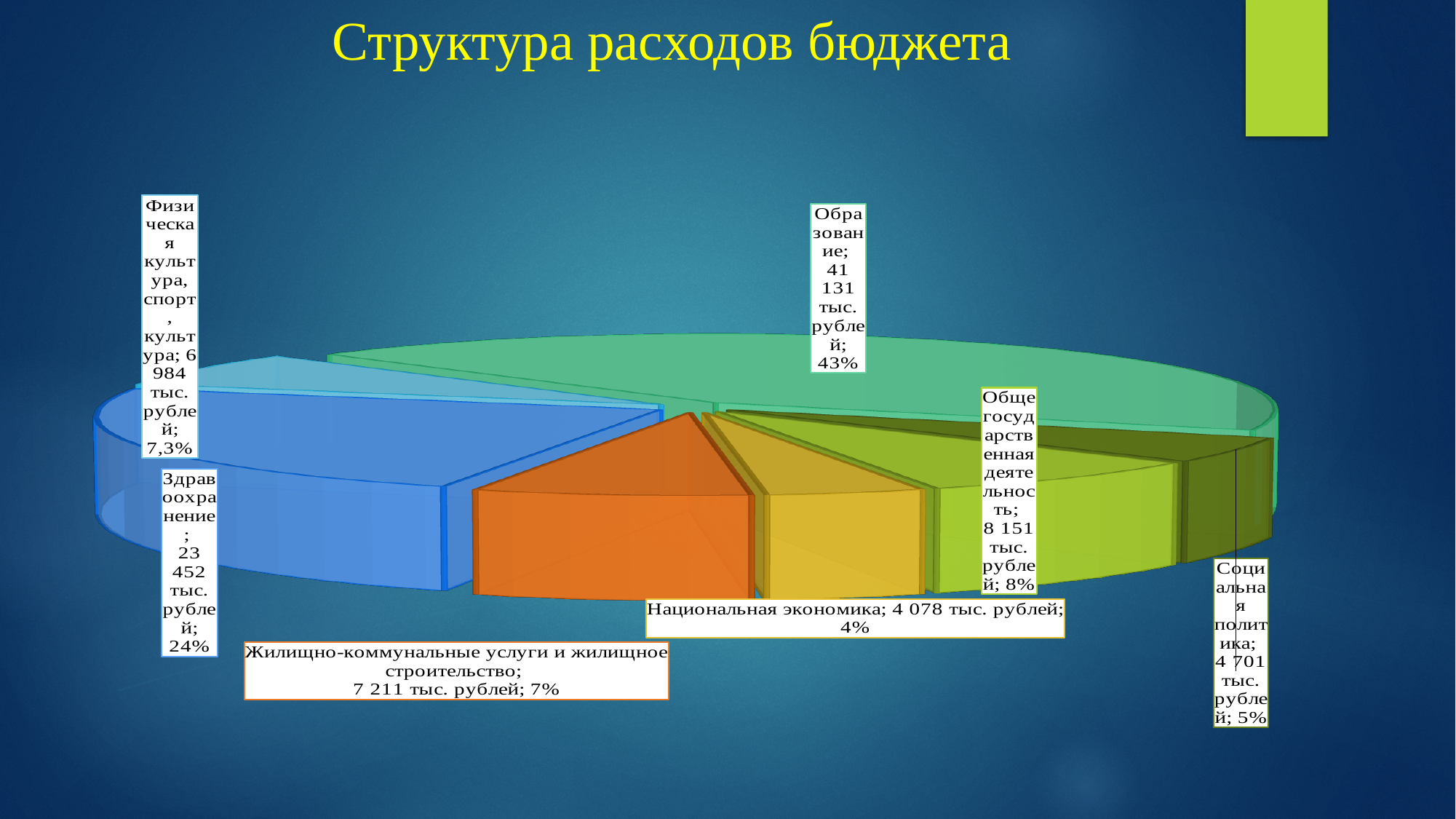
What is the value for Образование? 41 131 тыс. рублей What share of the pie does Физическая культура, спорт, культура take? 7,3% How many slices does the pie chart have? 7 What is the value for Социальная политика? 4 701 тыс. рублей What is the title of the chart? Структура расходов бюджета Which category has the largest share of the budget expenses? Образование Which is larger, the value for Общегосударственная деятельность or the value for Жилищно-коммунальные услуги и жилищное строительство? Общегосударственная деятельность What kind of chart is shown on the slide? pie chart What is the difference between the values for Образование and Здравоохранение? 17 679 тыс. рублей What is the value for Национальная экономика? 4 078 тыс. рублей What share of the pie does Здравоохранение take? 24% Which category has the smallest share of the budget expenses? Национальная экономика